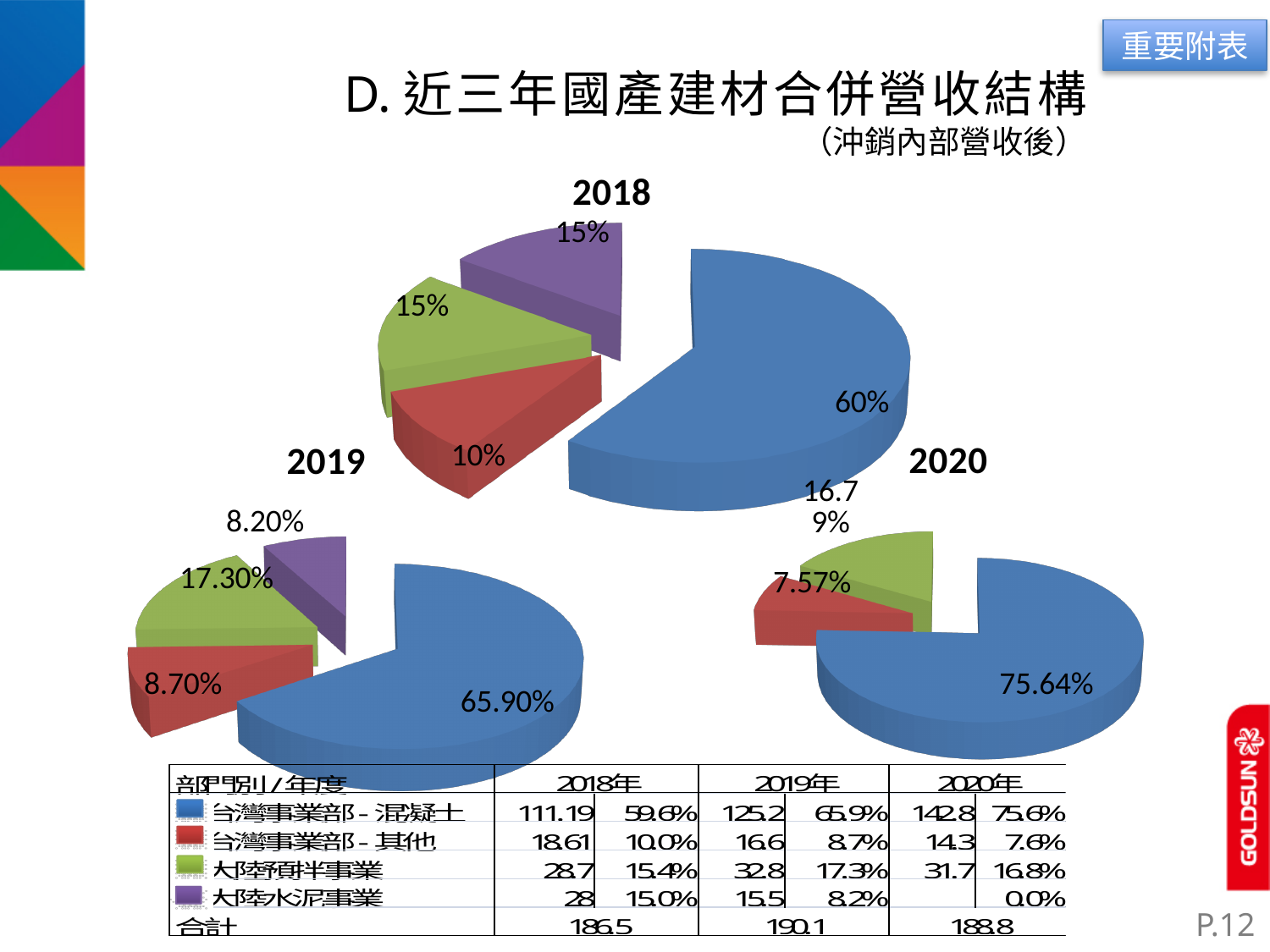
In the 2018 pie chart, what is the share of the largest slice? 60% What type of chart is used to show the 2018, 2019 and 2020 revenue structure? Pie chart In the 2020 pie chart, what share is shown for the blue slice (台灣事業部-混凝土)? 75.64% In the 2019 pie chart, what share is shown for the blue slice (台灣事業部-混凝土)? 65.90% How many slices does the 2020 pie chart have? 3 How many slices does the 2018 pie chart have? 4 In the 2019 pie chart, what is the share of the smallest slice? 8.20% In the 2018 pie chart, what share is shown for the red slice (台灣事業部-其他)? 10% Does the share of the blue slice (台灣事業部-混凝土) rise or fall from 2018 to 2020 across the three pie charts? Rise In the 2019 pie chart, what is the difference between the green slice (17.30%) and the red slice (8.70%)? 8.60 percentage points Which is larger: the blue slice in the 2019 pie chart or the blue slice in the 2018 pie chart? 2019 (65.90%) In the 2020 pie chart, what share is shown for the red slice (台灣事業部-其他)? 7.57%